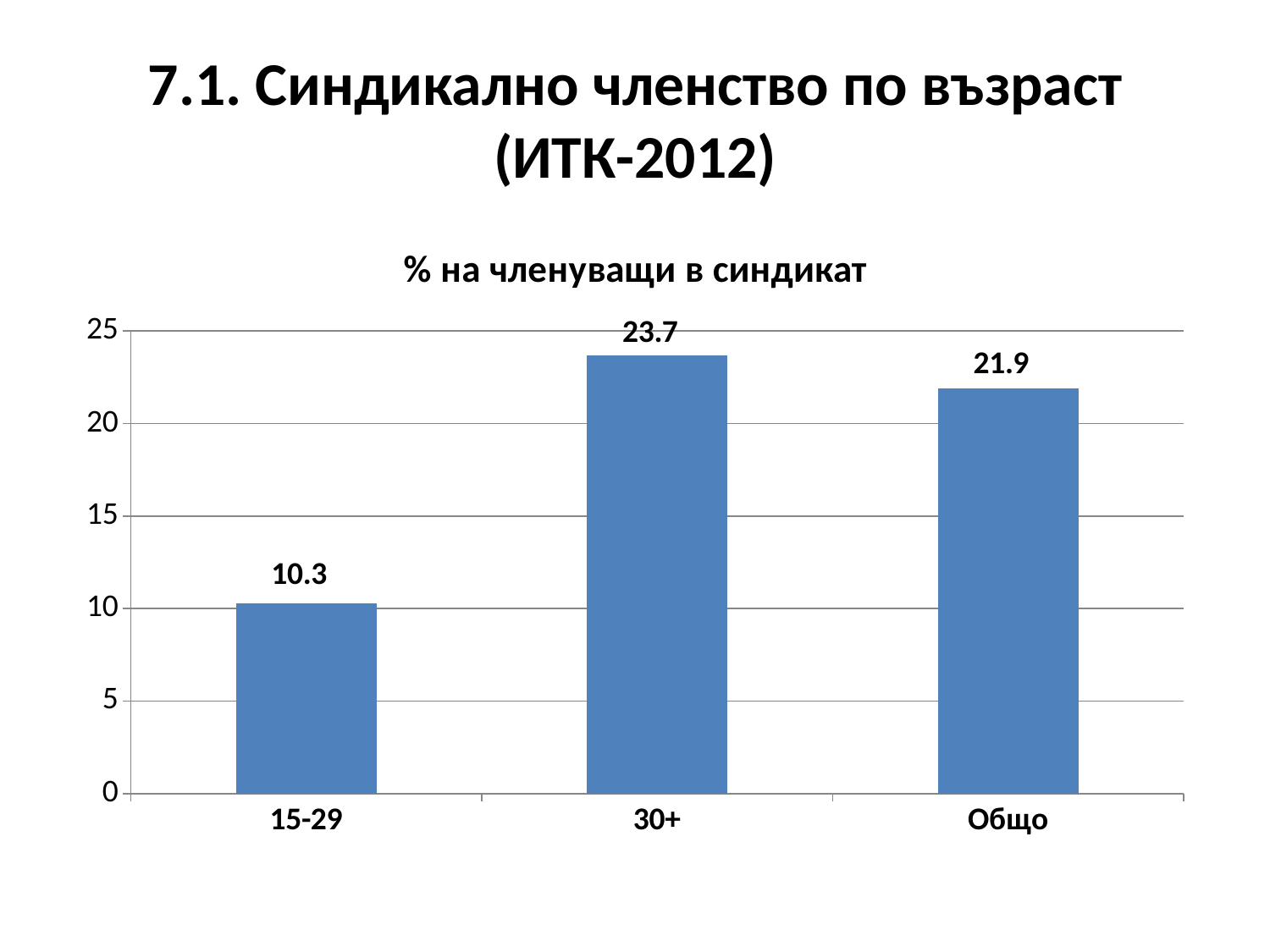
What is the value for the Общо category? 21.9 What is the value for the 30+ category? 23.7 What is the title of the chart? % на членуващи в синдикат What kind of chart is shown on the slide? bar chart What is the difference between the values for 30+ and 15-29? 13.4 Is the value for 15-29 greater or less than 15? less Which category has the highest value? 30+ Which is larger, the value for 15-29 or the value for Общо? Общо What is the value for the 15-29 category? 10.3 How many categories are shown on the x axis? 3 What is the difference between the values for 30+ and Общо? 1.8 Which category has the lowest value? 15-29